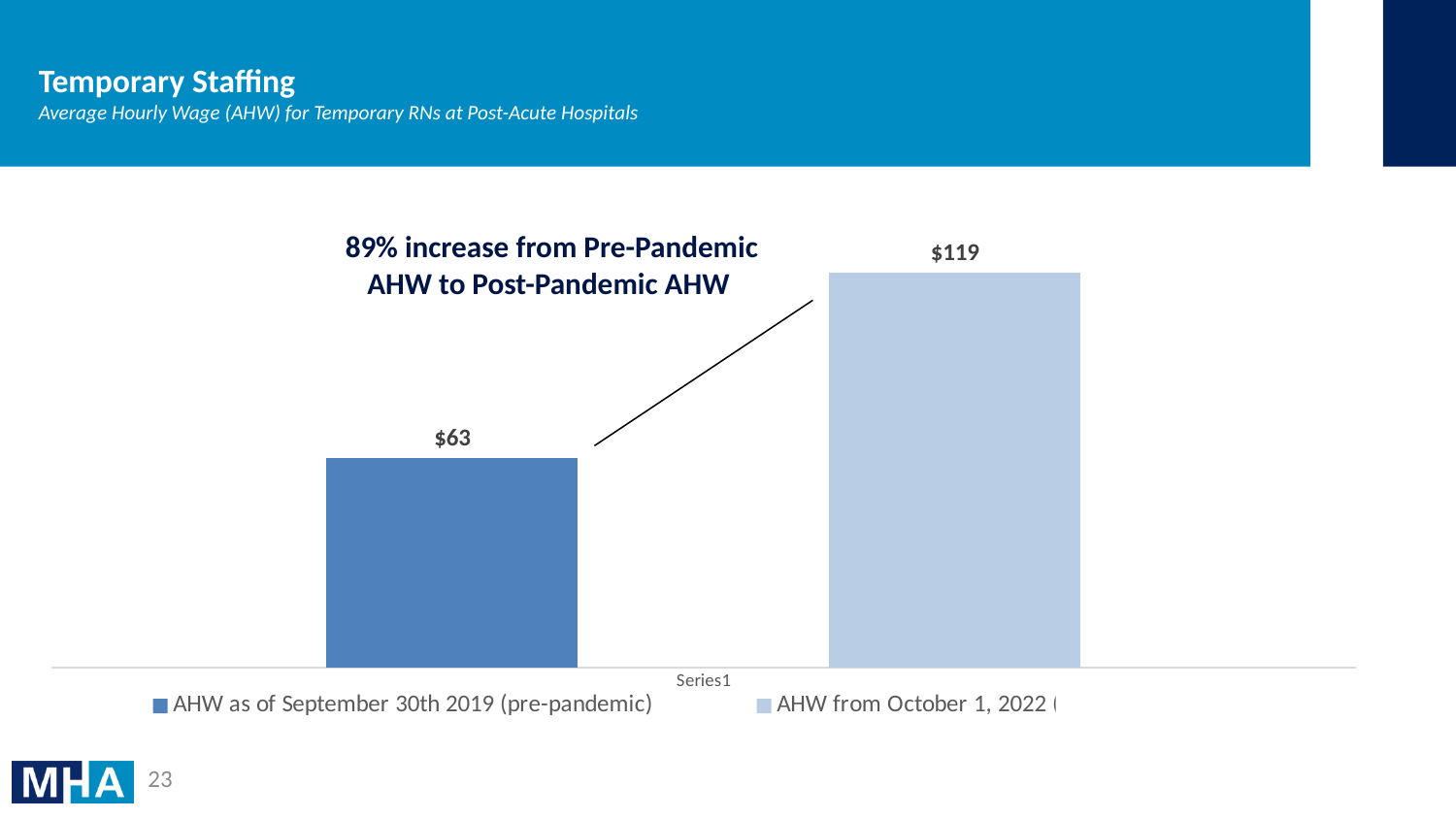
How many bars are plotted on the chart? 2 Do the bar values rise or fall from the pre-pandemic bar to the October 1, 2022 bar? Rise What is the AHW from October 1, 2022 shown on the chart? $119 How many series does the legend list? 2 What is the AHW as of September 30th 2019 (pre-pandemic) shown on the chart? $63 Which series has the higher value, the pre-pandemic AHW or the AHW from October 1, 2022? AHW from October 1, 2022 What is the category label shown on the x axis of the chart? Series1 Which series has the lowest value on the chart? AHW as of September 30th 2019 (pre-pandemic) What kind of chart is shown on the slide? Bar chart According to the text on the chart, what is the percentage increase from pre-pandemic AHW to post-pandemic AHW? 89% What is the difference between the AHW from October 1, 2022 and the pre-pandemic AHW? $56